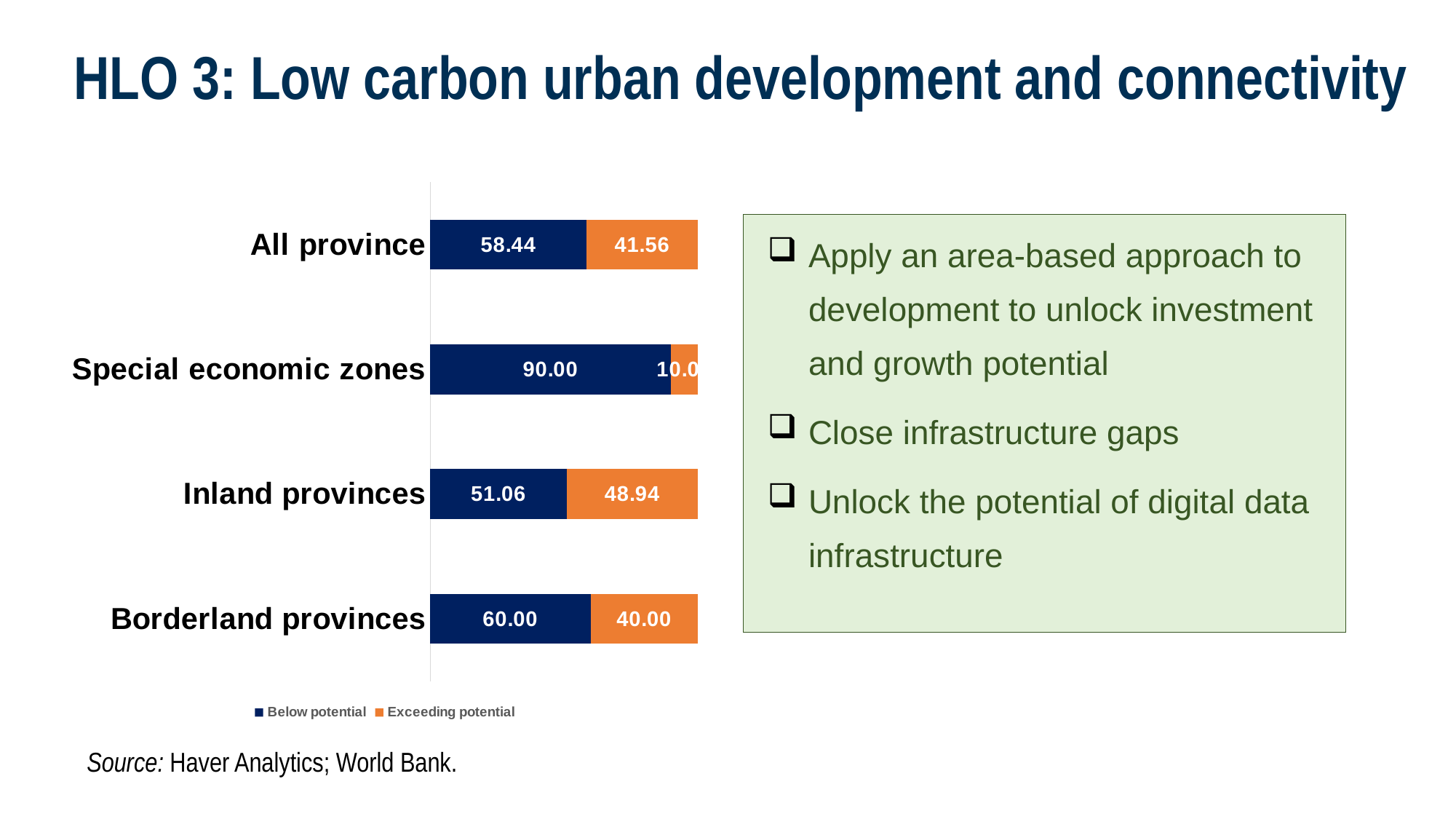
Which is larger: the Exceeding potential value for All province or for Borderland provinces? All province How many series does the legend list? 2 Which category has the lowest Below potential value? Inland provinces What is the Exceeding potential value for Inland provinces? 48.94 What is the Exceeding potential value for All province? 41.56 What is the Below potential value for Borderland provinces? 60.00 What is the Below potential value for All province? 58.44 Which category has the highest Below potential value? Special economic zones Which category has the highest Exceeding potential value? Inland provinces What is the difference between the Below potential values for Borderland provinces and Inland provinces? 8.94 What kind of chart is shown on the slide? Stacked bar chart How many categories are shown in the chart? 4